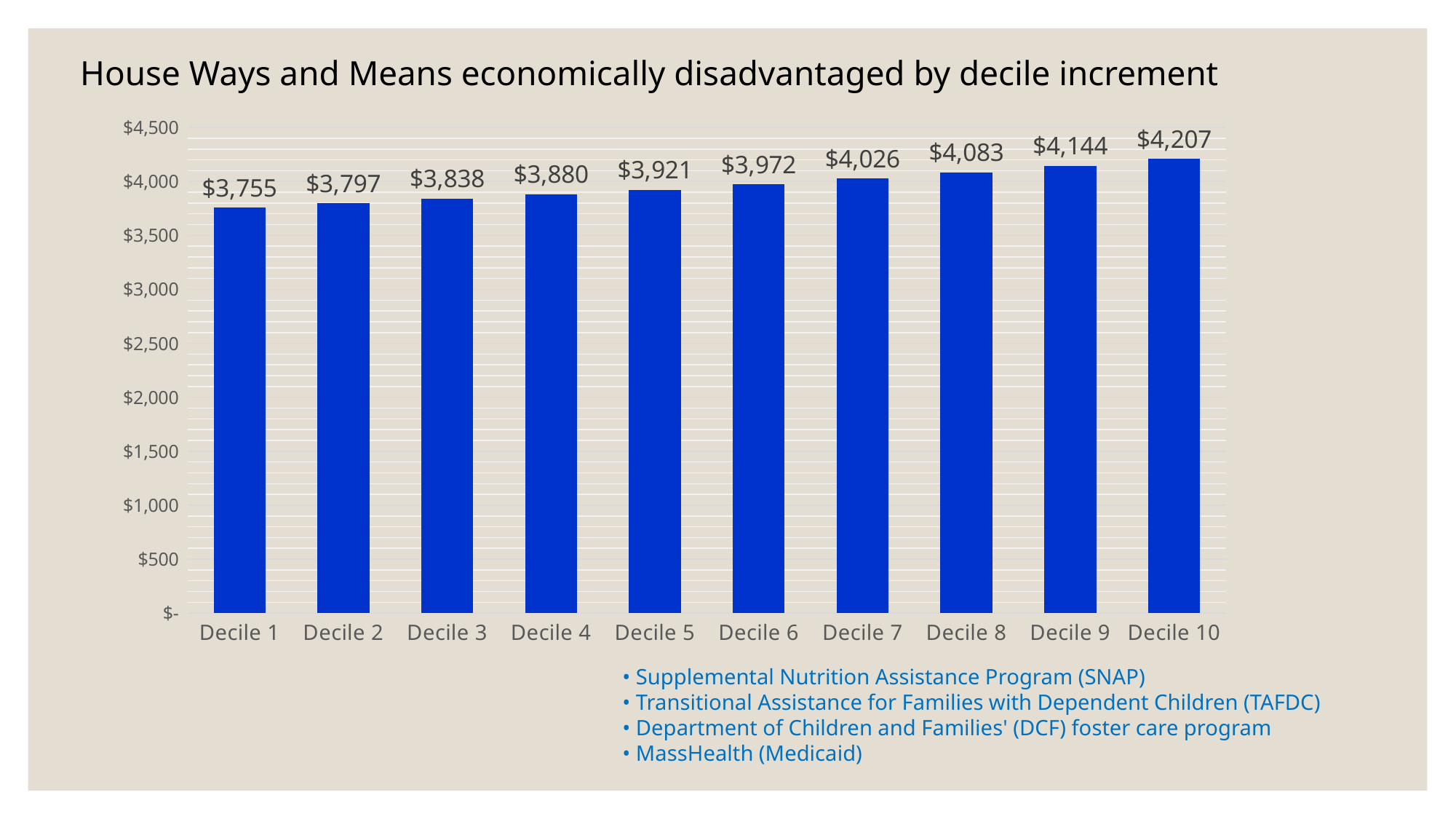
What is the difference between the values for Decile 10 and Decile 1? $452 What kind of chart is shown on the slide? bar chart What is the value for Decile 10? $4,207 What is the value for Decile 6? $3,972 What is the difference between the values for Decile 5 and Decile 4? $41 Which is larger, the value for Decile 3 or the value for Decile 8? Decile 8 Do the values rise or fall from Decile 1 to Decile 10? rise Which decile has the highest value? Decile 10 What is the value for Decile 1? $3,755 Is the value for Decile 7 greater or less than $4,000? greater How many deciles are shown on the x axis? 10 Which decile has the lowest value? Decile 1